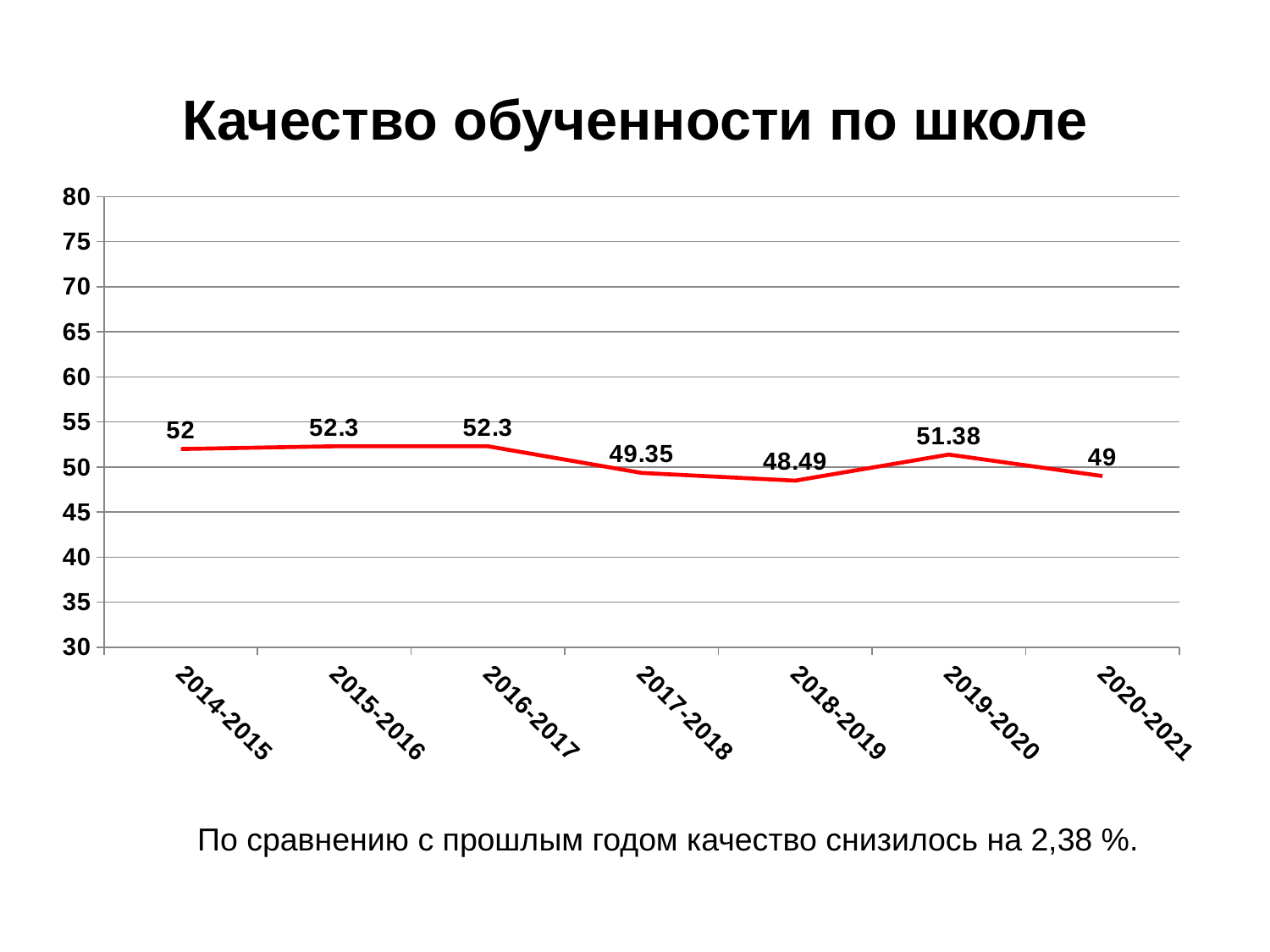
Which is larger, the value for 2018-2019 or the value for 2019-2020? 2019-2020 What is the difference between the values for 2016-2017 and 2017-2018? 2.95 What kind of chart is shown on the slide? line chart Which year has the lowest value? 2018-2019 What is the value for 2019-2020? 51.38 How many school years are plotted on the chart? 7 What is the difference between the values for 2019-2020 and 2020-2021? 2.38 Is the value for 2018-2019 greater or less than 50? less What is the value for 2020-2021? 49 What is the value for 2017-2018? 49.35 What is the title of the chart? Качество обученности по школе What is the value for 2014-2015? 52